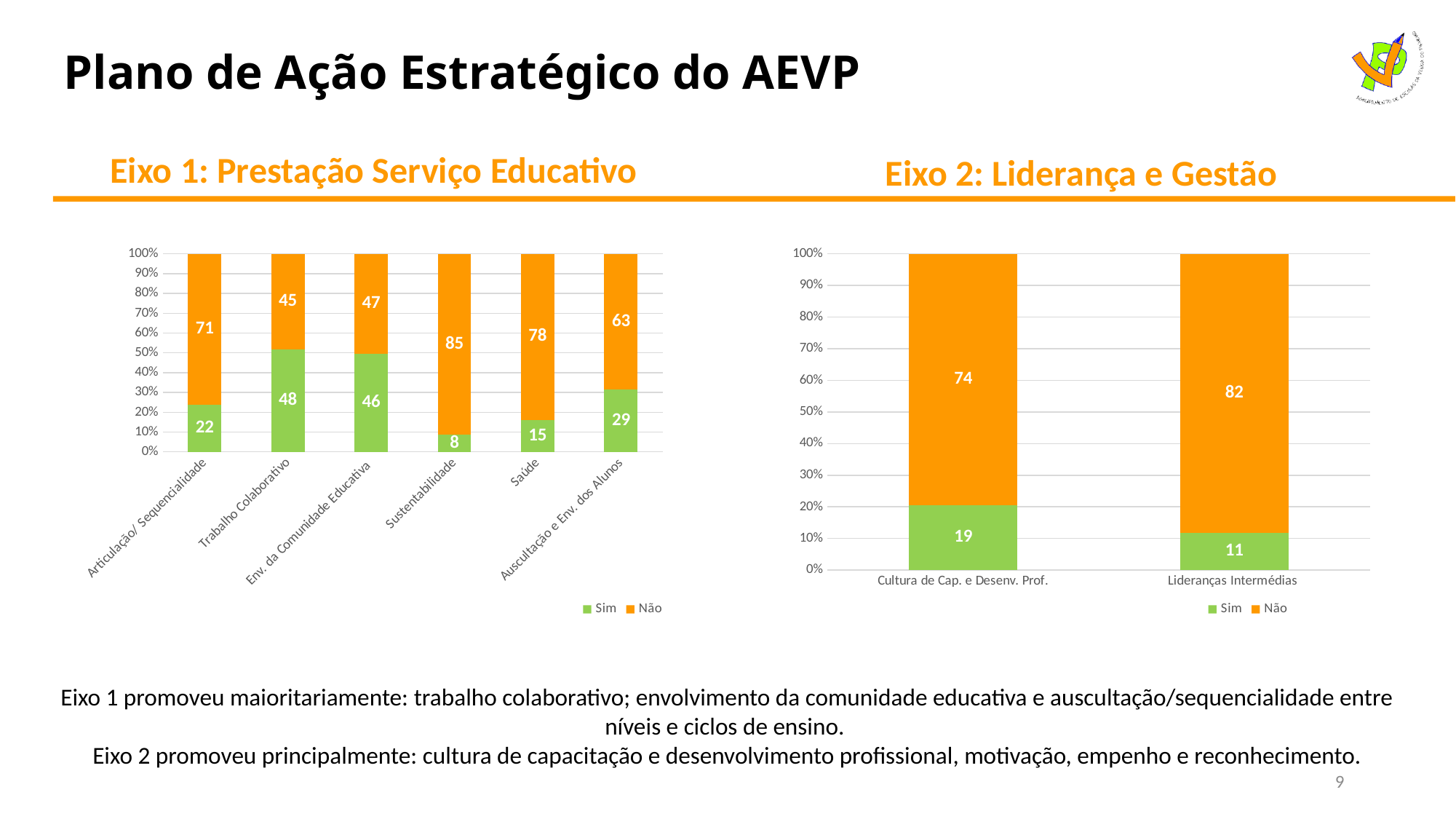
In the Eixo 2: Liderança e Gestão chart, what is the Sim value for Cultura de Cap. e Desenv. Prof.? 19 How many series does the legend of the Eixo 2: Liderança e Gestão chart list? 2 In the Eixo 1: Prestação Serviço Educativo chart, is the Sim value for Articulação/ Sequencialidade larger or smaller than the Sim value for Auscultação e Env. dos Alunos? smaller In the Eixo 2: Liderança e Gestão chart, what is the Não value for Lideranças Intermédias? 82 In the Eixo 1: Prestação Serviço Educativo chart, which category has the highest Não value? Sustentabilidade In the Eixo 1: Prestação Serviço Educativo chart, what is the difference between the Não and Sim values for Saúde? 63 In the Eixo 2: Liderança e Gestão chart, what is the total of the Sim and Não values for Lideranças Intermédias? 93 In the Eixo 1: Prestação Serviço Educativo chart, what is the Não value for Sustentabilidade? 85 In the Eixo 1: Prestação Serviço Educativo chart, what is the Sim value for Trabalho Colaborativo? 48 In the Eixo 1: Prestação Serviço Educativo chart, how many categories are shown on the x axis? 6 In the Eixo 1: Prestação Serviço Educativo chart, which category has the lowest Sim value? Sustentabilidade What kind of chart is the Eixo 1: Prestação Serviço Educativo chart? Stacked bar chart